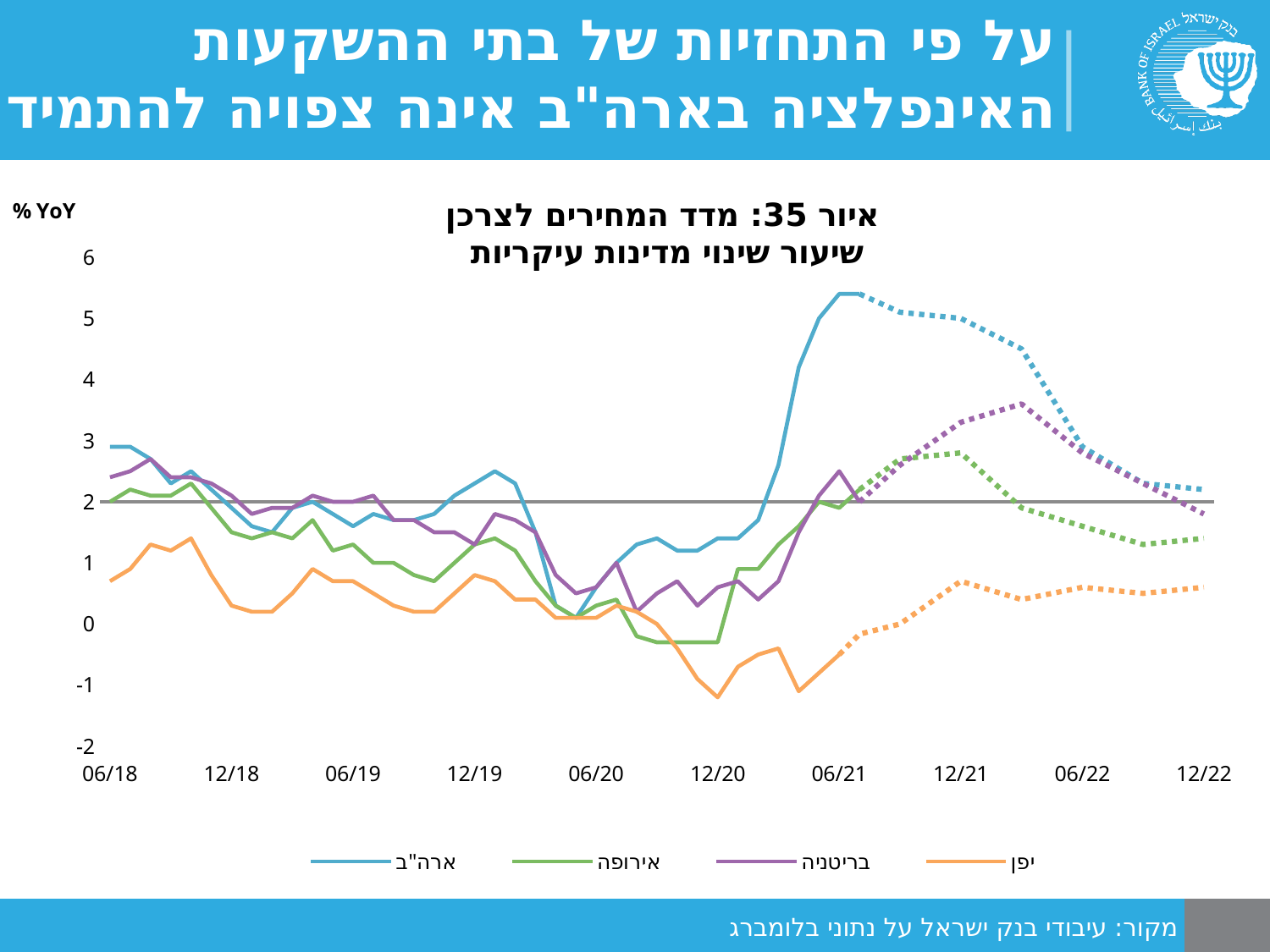
At 12/21, which series has the higher value, ארה"ב or יפן? ארה"ב What kind of chart is shown on the slide? line chart Which series are listed in the legend? ארה"ב, אירופה, בריטניה, יפן What unit is shown on the y axis? % YoY Is the value for יפן at 12/20 greater or less than 0? less Which series reaches the lowest value anywhere on the chart? יפן How many series does the legend list? 4 Is the value for אירופה at 12/22 greater or less than 2? less Which series reaches the highest value anywhere on the chart? ארה"ב Does the בריטניה line rise or fall between 12/20 and 12/21? rise Does the ארה"ב line rise or fall between 06/21 and 12/22? fall Is the value for ארה"ב at 06/21 greater or less than 4? greater